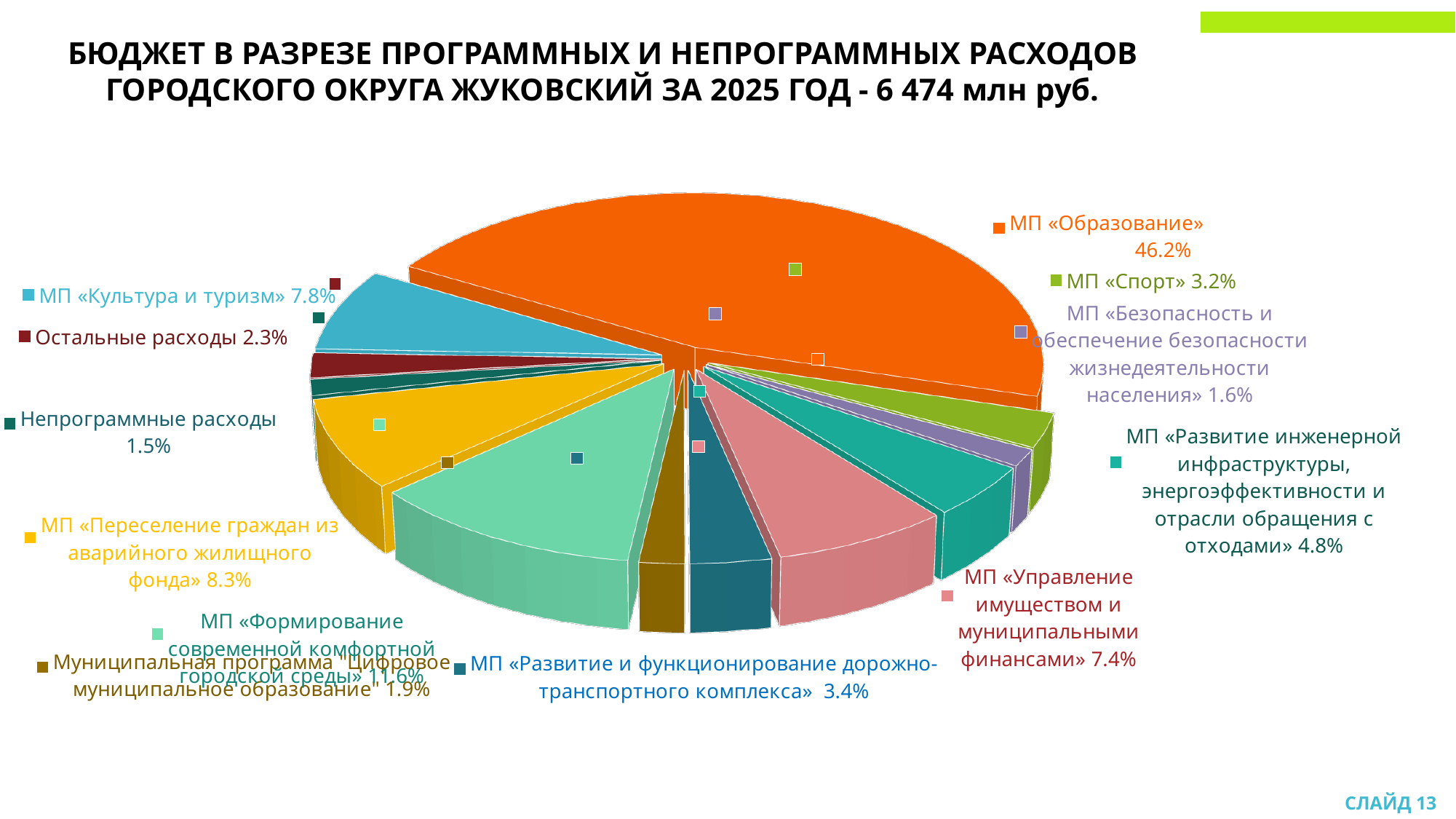
What is the difference in percentage points between МП «Переселение граждан из аварийного жилищного фонда» and МП «Управление имуществом и муниципальными финансами»? 0.9 What share is shown for МП «Формирование современной комфортной городской среды»? 11.6% What percentage is shown for Непрограммные расходы? 1.5% What total budget amount is stated in the chart title? 6 474 млн руб. What percentage is shown for МП «Культура и туризм»? 7.8% What type of chart is shown on the slide? Pie chart Which category has the largest share of the pie? МП «Образование» What share of the budget does МП «Образование» account for? 46.2% Which is larger: the share of МП «Спорт» or the share of МП «Развитие и функционирование дорожно-транспортного комплекса»? МП «Развитие и функционирование дорожно-транспортного комплекса» What colour is the slice for МП «Образование»? Orange Which category has the smallest share of the pie? Непрограммные расходы How many categories are shown in the pie chart? 12